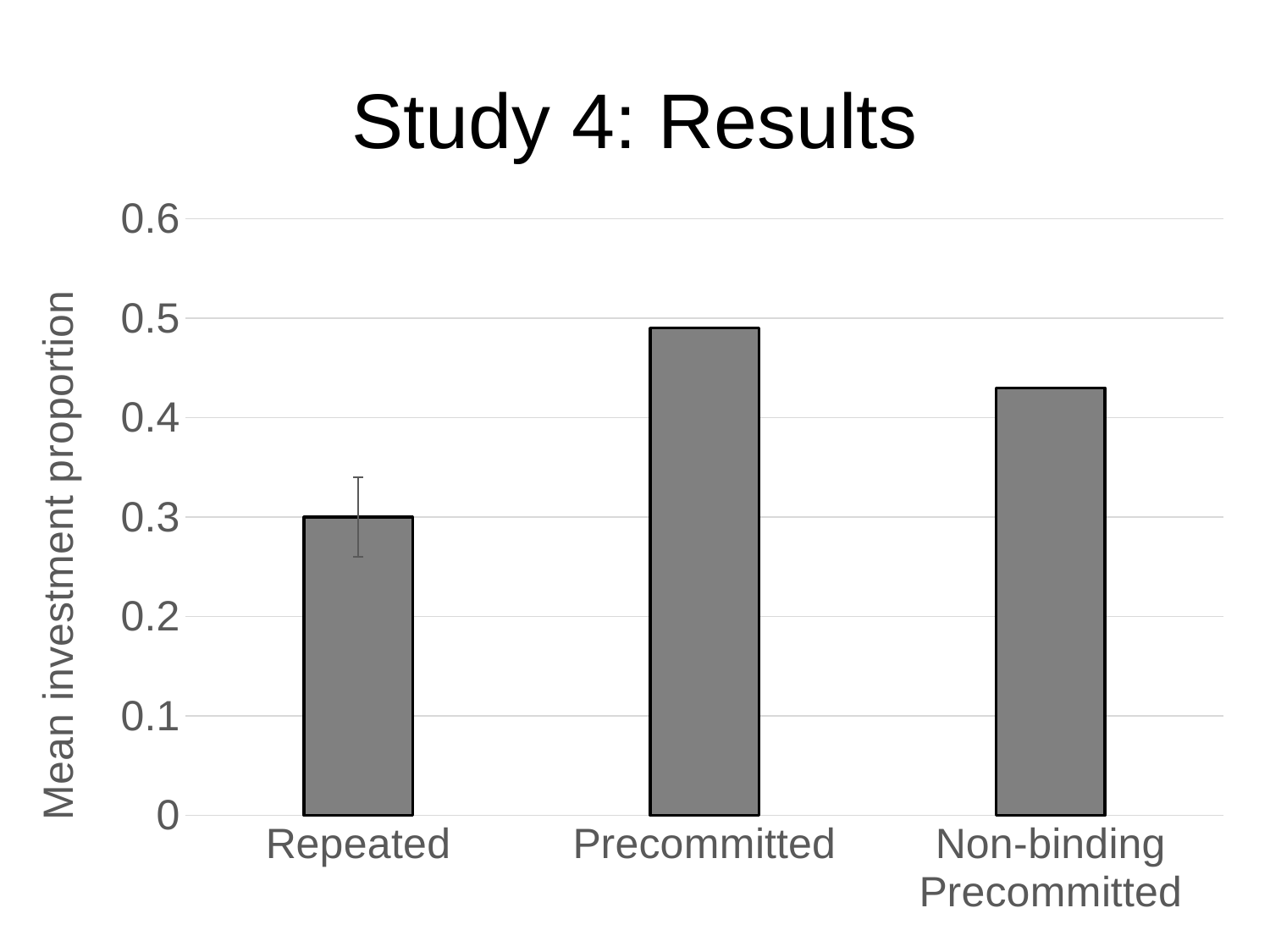
Which category has the lowest mean investment proportion? Repeated Is the value for Non-binding Precommitted greater or less than 0.5? less Is the value for Precommitted greater or less than 0.4? greater How many categories are shown on the x axis? 3 What is the mean investment proportion for Repeated? 0.3 Which is larger, the value for Precommitted or the value for Non-binding Precommitted? Precommitted What is the title of the chart? Study 4: Results Which is larger, the value for Repeated or the value for Non-binding Precommitted? Non-binding Precommitted Which category has the highest mean investment proportion? Precommitted What is the label on the vertical axis? Mean investment proportion Is the value for Repeated greater or less than 0.4? less What kind of chart is shown on the slide? bar chart